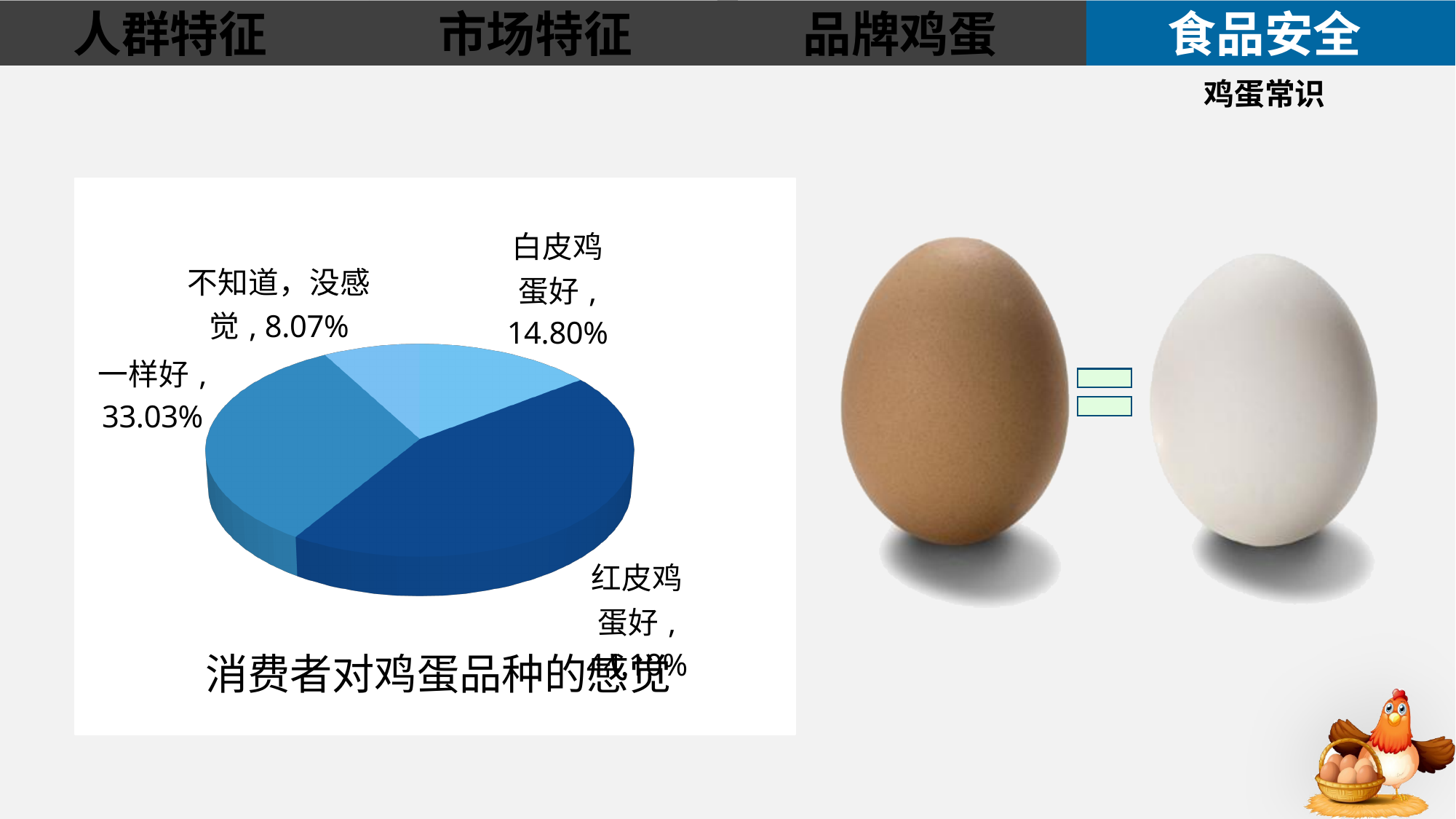
Which is larger, the share for 红皮鸡蛋好 or the share for 一样好? 红皮鸡蛋好 Which category has the largest slice of the pie? 红皮鸡蛋好 What percentage of consumers answered 一样好? 33.03% What percentage of consumers answered 不知道，没感觉? 8.07% How many slices does the pie chart have? 4 What is the difference between the 白皮鸡蛋好 share and the 不知道，没感觉 share? 6.73% Which category has the smallest slice of the pie? 不知道，没感觉 Which is larger, the share for 一样好 or the share for 白皮鸡蛋好? 一样好 What is the title of the chart? 消费者对鸡蛋品种的感觉 What kind of chart is shown on the slide? Pie chart What is the difference between the 一样好 share and the 白皮鸡蛋好 share? 18.23% What percentage of consumers answered 白皮鸡蛋好? 14.80%